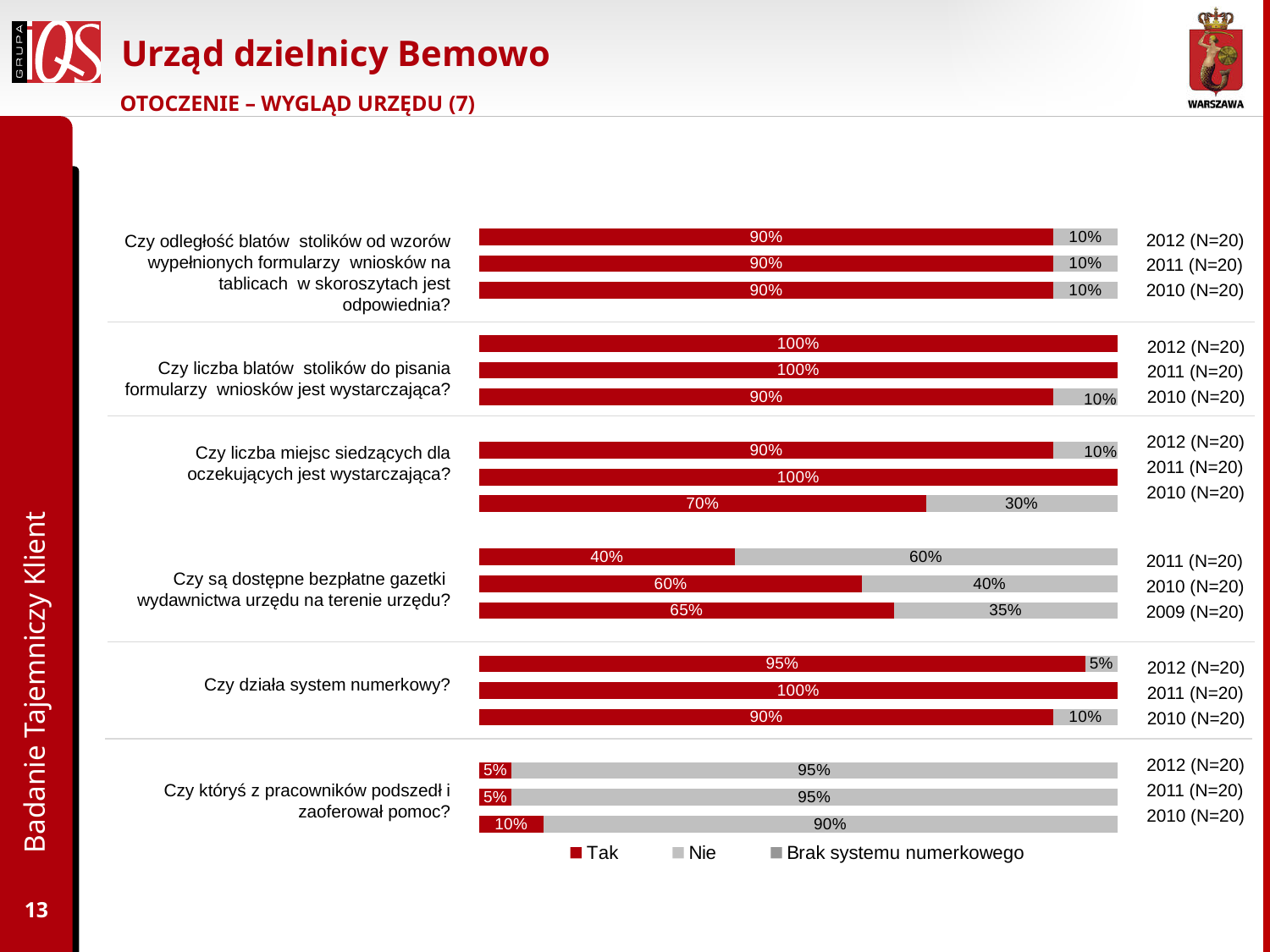
What kind of chart is shown on the slide? Stacked bar chart For the question "Czy są dostępne bezpłatne gazetki wydawnictwa urzędu na terenie urzędu?", does the "Tak" value rise or fall from 2009 to 2011? Fall How many series does the chart legend list? 3 For the question "Czy działa system numerkowy?", what is the "Tak" value for 2012 (N=20)? 95% For the question "Czy są dostępne bezpłatne gazetki wydawnictwa urzędu na terenie urzędu?", what is the total of the stacked bar for 2011 (N=20)? 100% How many year rows are shown for the question "Czy działa system numerkowy?"? 3 For the question "Czy są dostępne bezpłatne gazetki wydawnictwa urzędu na terenie urzędu?", which year has the larger "Tak" value, 2010 or 2009? 2009 For the question "Czy liczba miejsc siedzących dla oczekujących jest wystarczająca?" in 2010, what is the difference between the "Tak" and "Nie" values? 40 percentage points For the question "Czy są dostępne bezpłatne gazetki wydawnictwa urzędu na terenie urzędu?", what is the "Nie" value for 2011 (N=20)? 60% For the question "Czy któryś z pracowników podszedł i zaoferował pomoc?", what is the "Tak" value for 2010 (N=20)? 10% For the question "Czy liczba miejsc siedzących dla oczekujących jest wystarczająca?", what is the "Tak" value for 2010 (N=20)? 70% For the question "Czy są dostępne bezpłatne gazetki wydawnictwa urzędu na terenie urzędu?", which year has the lowest "Tak" value? 2011